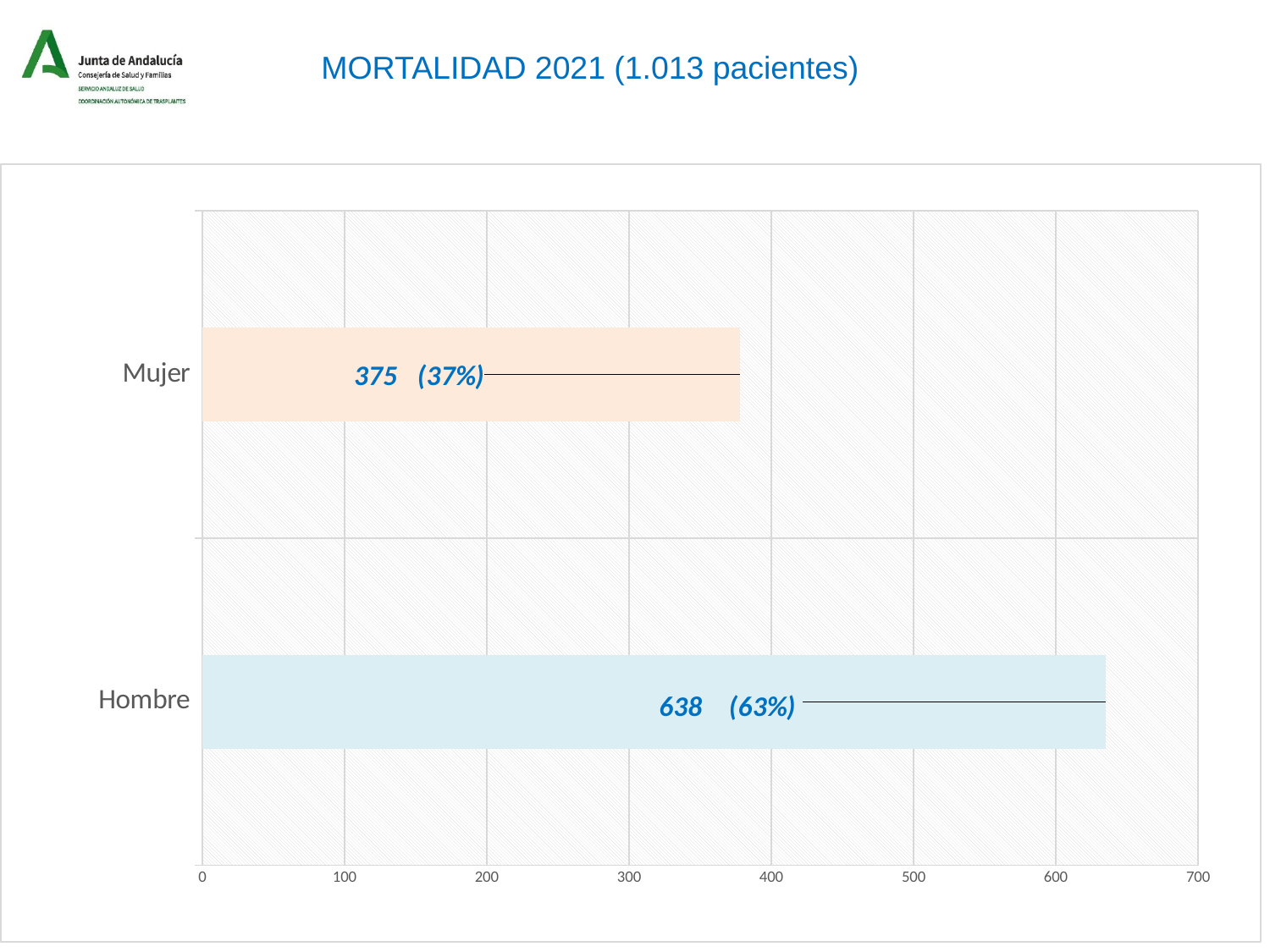
What is the title of the slide? MORTALIDAD 2021 (1.013 pacientes) Which category has the highest value? Hombre Which category has the lowest value? Mujer Is the value for Mujer greater or less than 400? less What is the value for Mujer? 375 What is the value for Hombre? 638 What percentage is shown for Hombre? 63% How many categories are shown in the chart? 2 Which is larger, the value for Hombre or the value for Mujer? Hombre What is the difference between the values for Hombre and Mujer? 263 What percentage is shown for Mujer? 37% What kind of chart is shown on the slide? bar chart